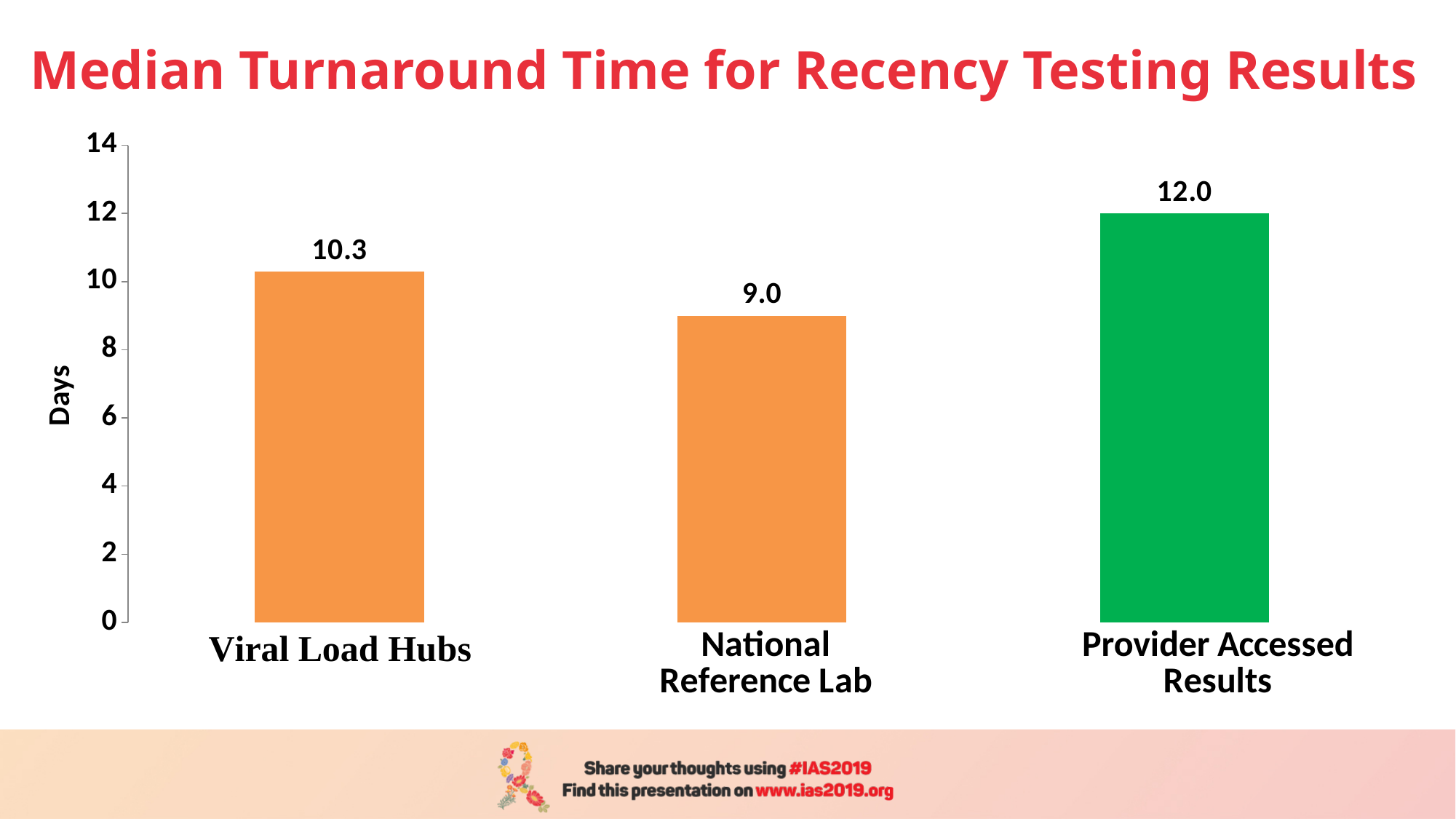
What is the median turnaround time for Provider Accessed Results? 12.0 What kind of chart is shown on the slide? Bar chart Which category has the lowest median turnaround time? National Reference Lab How many categories are shown in the chart? 3 Which has a longer median turnaround time, Viral Load Hubs or National Reference Lab? Viral Load Hubs What is the difference in days between Provider Accessed Results and National Reference Lab? 3.0 What is the label on the vertical axis of the chart? Days Which category has the highest median turnaround time? Provider Accessed Results Is the value for Provider Accessed Results greater or less than 10? greater What is the difference in days between Viral Load Hubs and National Reference Lab? 1.3 What is the median turnaround time for National Reference Lab? 9.0 What is the median turnaround time for Viral Load Hubs? 10.3